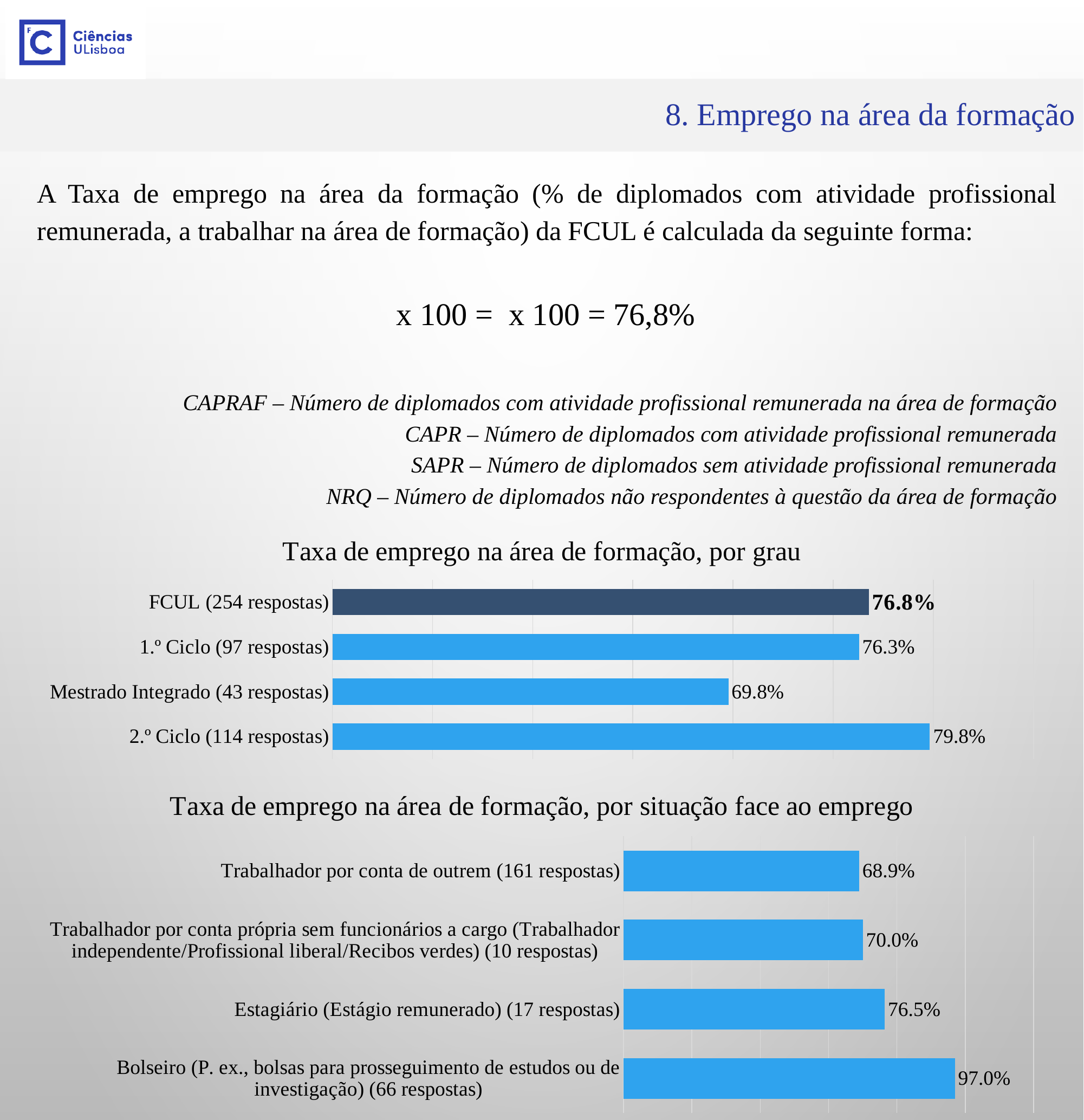
In the chart 'Taxa de emprego na área de formação, por grau', which category has the highest value? 2.º Ciclo (114 respostas) In the chart 'Taxa de emprego na área de formação, por situação face ao emprego', what is the value for Estagiário (Estágio remunerado) (17 respostas)? 76.5% In the chart 'Taxa de emprego na área de formação, por situação face ao emprego', which is larger: the value for Estagiário or the value for Trabalhador por conta de outrem? Estagiário In the chart 'Taxa de emprego na área de formação, por grau', which category has the lowest value? Mestrado Integrado (43 respostas) In the chart 'Taxa de emprego na área de formação, por situação face ao emprego', what is the value for Bolseiro (66 respostas)? 97.0% What kind of chart is 'Taxa de emprego na área de formação, por grau'? Bar chart In the chart 'Taxa de emprego na área de formação, por grau', how many categories are shown? 4 In the chart 'Taxa de emprego na área de formação, por situação face ao emprego', what is the difference between the values for Bolseiro and Trabalhador por conta de outrem? 28.1% In the chart 'Taxa de emprego na área de formação, por situação face ao emprego', which category has the lowest value? Trabalhador por conta de outrem (161 respostas) In the chart 'Taxa de emprego na área de formação, por grau', what is the value for 2.º Ciclo (114 respostas)? 79.8% In the chart 'Taxa de emprego na área de formação, por grau', what is the value for Mestrado Integrado (43 respostas)? 69.8% In the chart 'Taxa de emprego na área de formação, por grau', what is the difference between the values for 2.º Ciclo and Mestrado Integrado? 10.0%